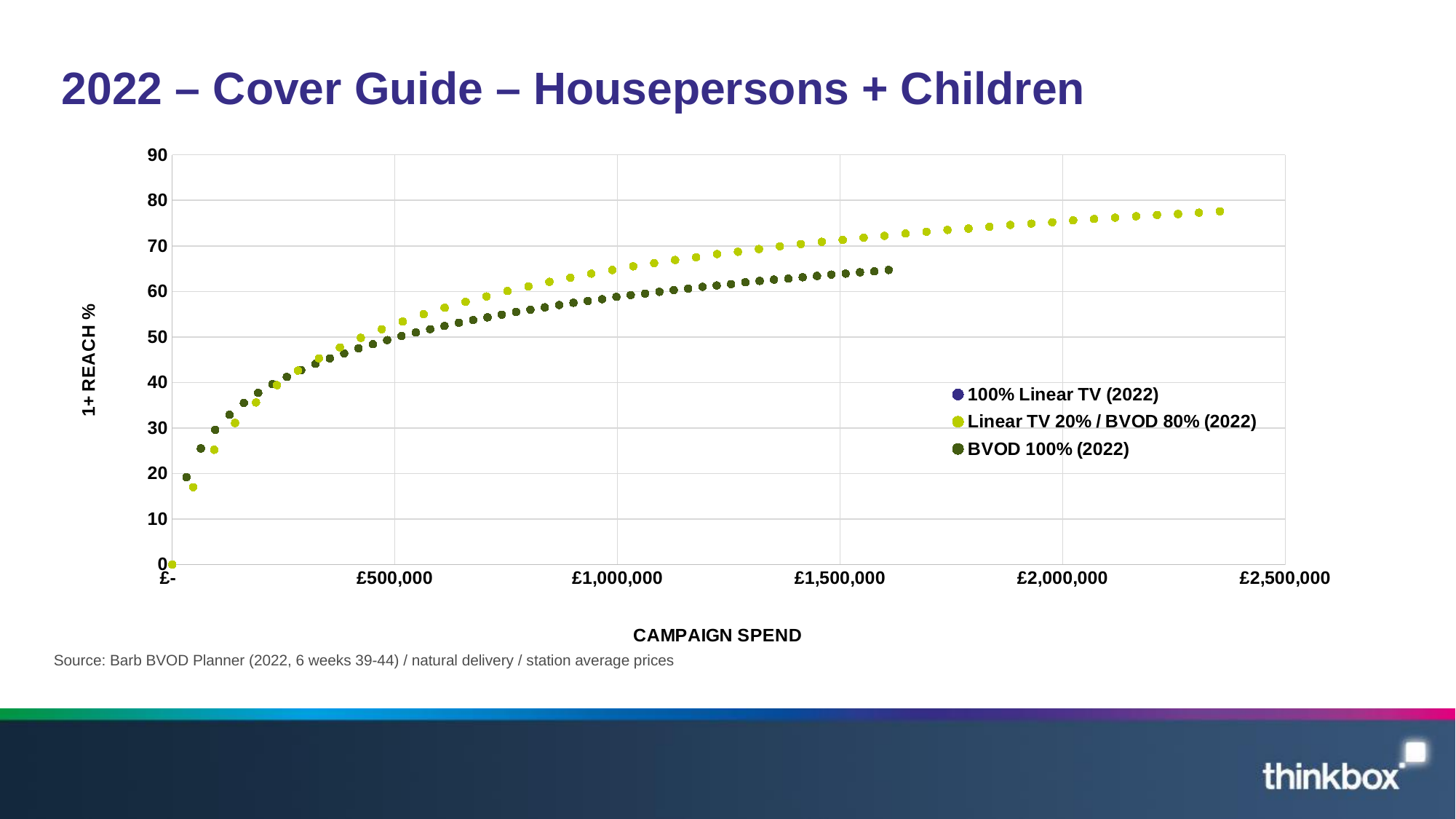
What is the title of the slide's chart? 2022 – Cover Guide – Housepersons + Children At a campaign spend of £1,500,000, which series has the higher 1+ reach %: Linear TV 20% / BVOD 80% (2022) or BVOD 100% (2022)? Linear TV 20% / BVOD 80% (2022) Is the 1+ reach % for Linear TV 20% / BVOD 80% (2022) at a campaign spend of £2,000,000 greater or less than 70? greater Which series reaches the highest 1+ reach % on the chart? Linear TV 20% / BVOD 80% (2022) What is the label of the vertical axis? 1+ REACH % What kind of chart is shown on the slide? Scatter chart Does 1+ reach % rise or fall as campaign spend increases for the Linear TV 20% / BVOD 80% (2022) series? Rise Is the 1+ reach % for Linear TV 20% / BVOD 80% (2022) at a campaign spend of £1,000,000 greater or less than 60? greater Does 1+ reach % rise or fall as campaign spend increases for the BVOD 100% (2022) series? Rise Is the 1+ reach % for BVOD 100% (2022) at a campaign spend of £1,500,000 greater or less than 60? greater How many series does the legend list? 3